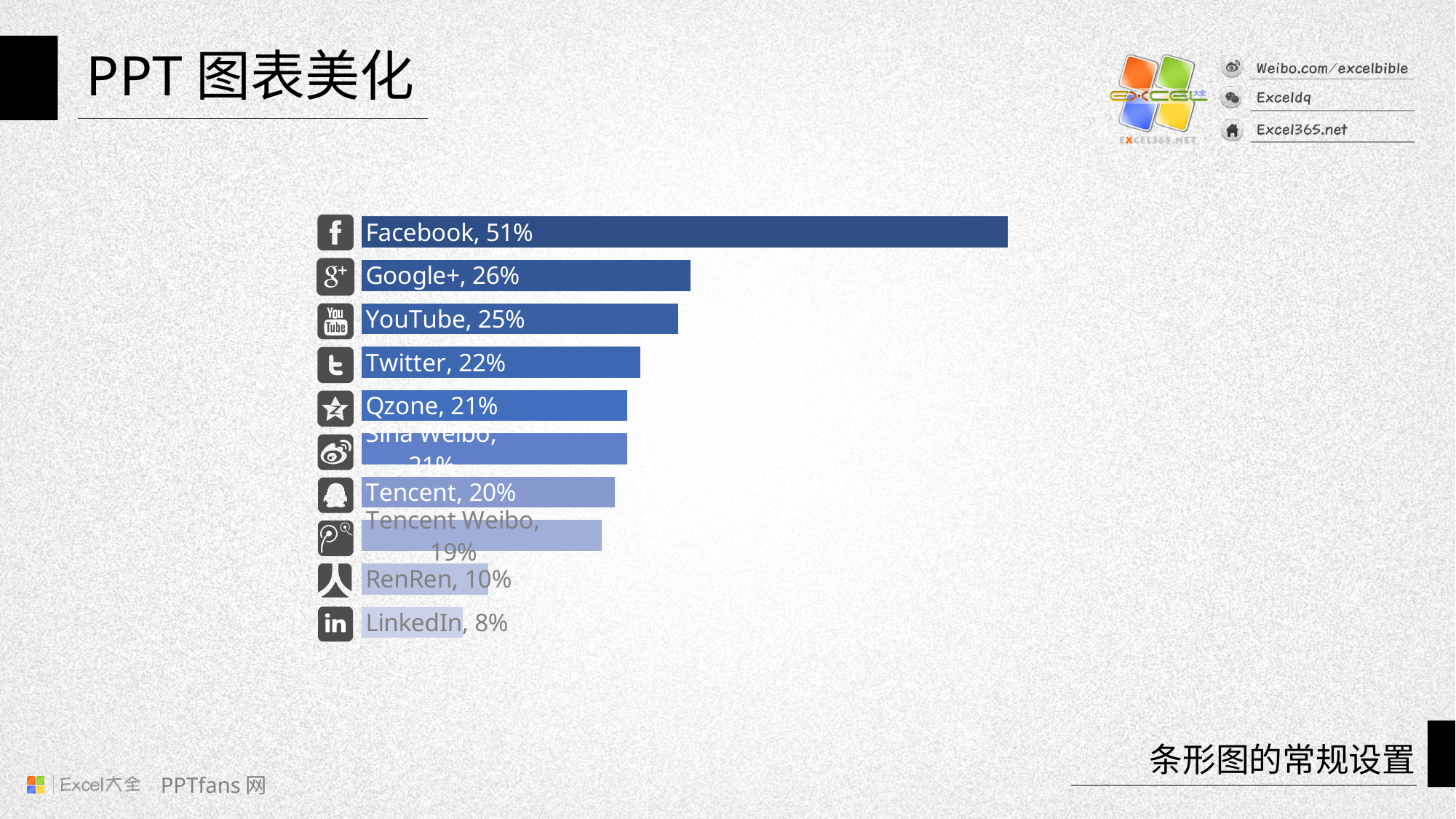
Which category has the lowest value? LinkedIn What is the difference between the values for Facebook and Google+? 25% Which category has the highest value? Facebook What is the value for Tencent Weibo? 19% Which is larger, the value for YouTube or the value for Tencent? YouTube What is the value for Twitter? 22% What is the value for LinkedIn? 8% What kind of chart is shown on the slide? bar chart What is the value for Facebook? 51% How many categories (bars) does the chart show? 10 What is the difference between the values for RenRen and LinkedIn? 2% What is the value for Google+? 26%